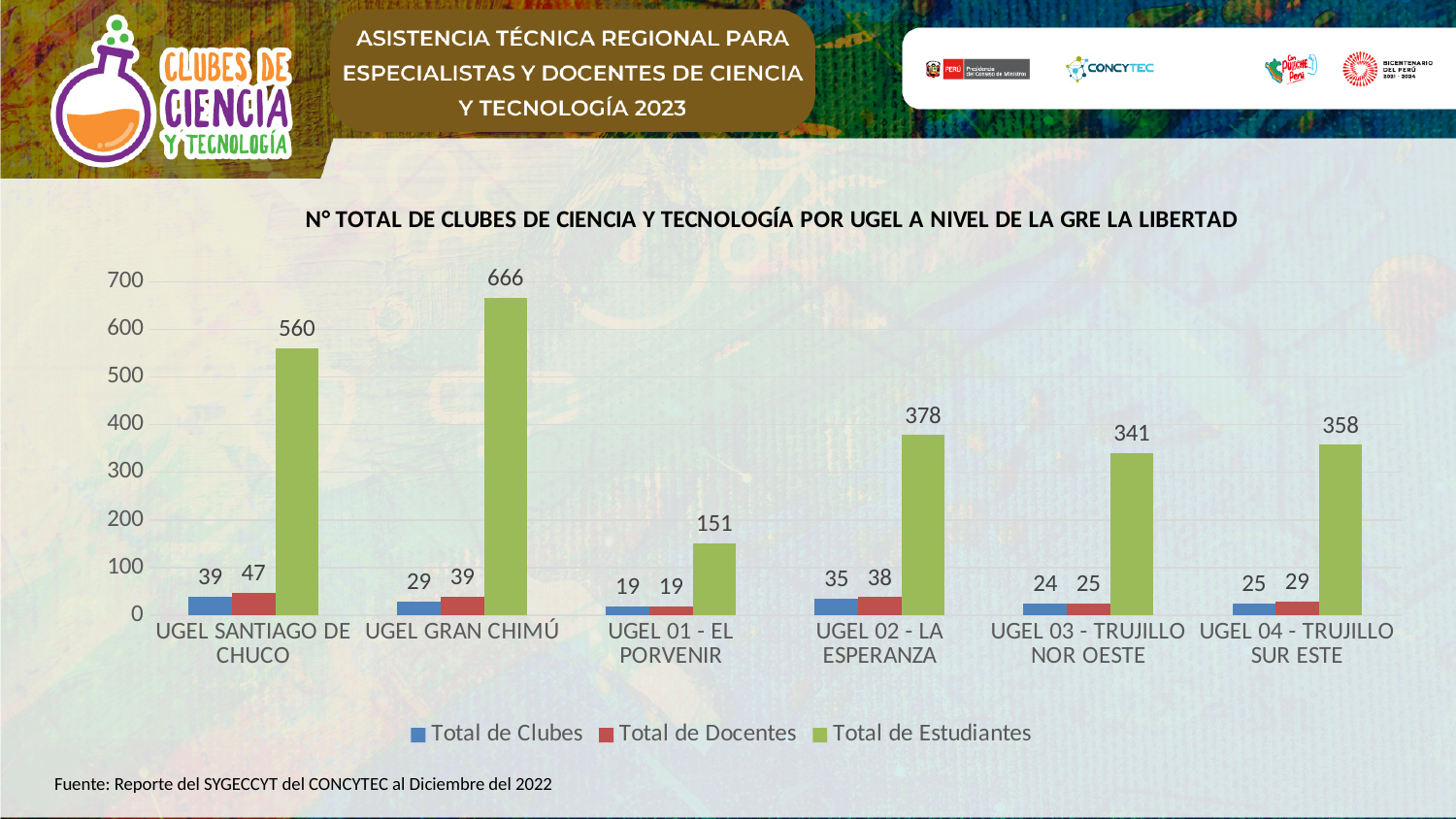
Which UGEL has the highest Total de Estudiantes? UGEL GRAN CHIMÚ What is the difference in Total de Estudiantes between UGEL GRAN CHIMÚ and UGEL SANTIAGO DE CHUCO? 106 How many UGEL categories are shown on the x axis? 6 How many series does the legend list? 3 What is the Total de Estudiantes for UGEL GRAN CHIMÚ? 666 Which is larger: the Total de Estudiantes for UGEL 04 - TRUJILLO SUR ESTE or for UGEL 03 - TRUJILLO NOR OESTE? UGEL 04 - TRUJILLO SUR ESTE What is the Total de Clubes for UGEL SANTIAGO DE CHUCO? 39 Which colour represents Total de Docentes in the legend? Red What is the Total de Docentes for UGEL 02 - LA ESPERANZA? 38 What kind of chart is shown on the slide? Bar chart Which UGEL has the lowest Total de Clubes? UGEL 01 - EL PORVENIR Is the Total de Estudiantes for UGEL 01 - EL PORVENIR greater or less than 200? less